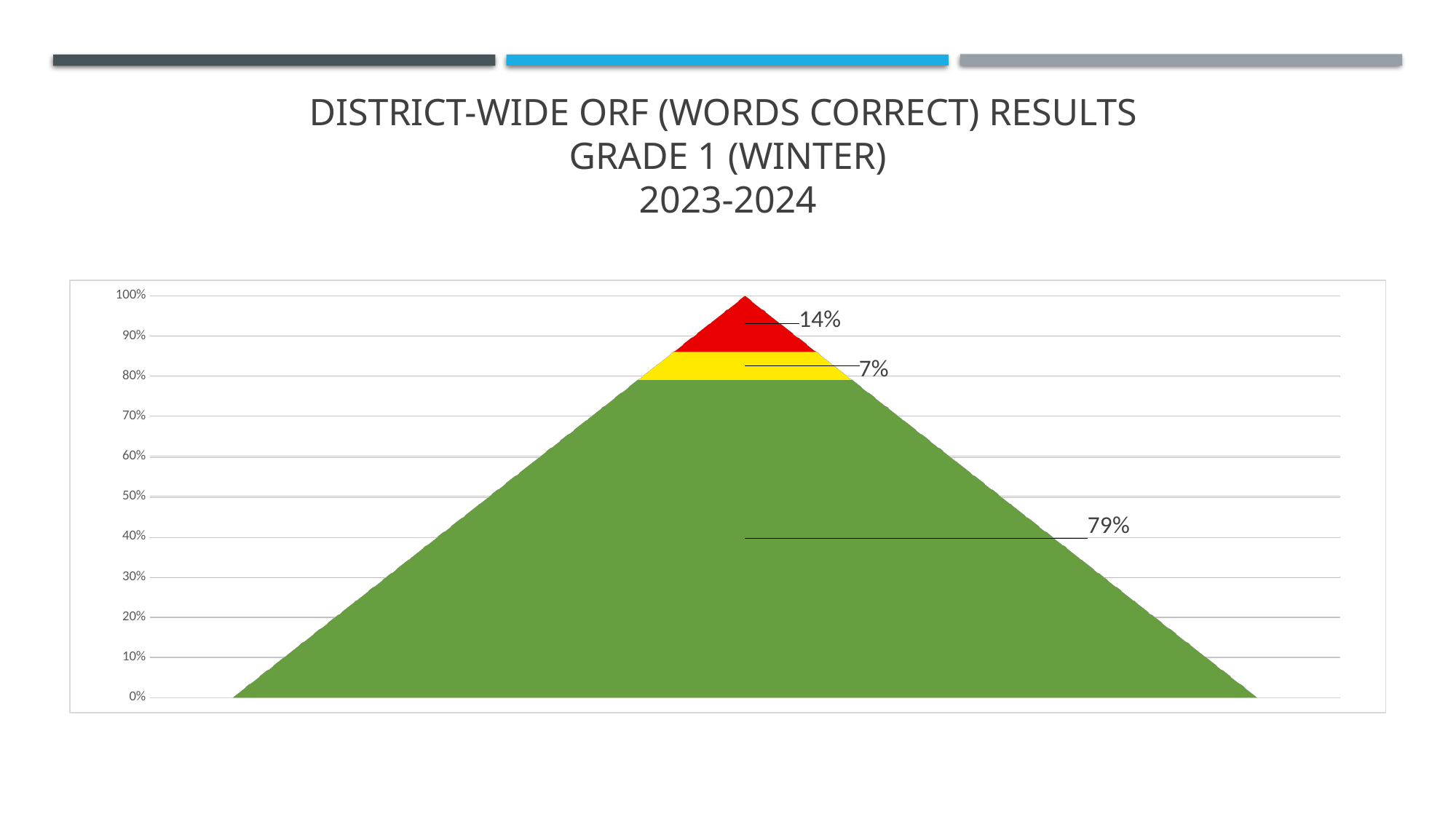
What is the difference between the green segment's percentage and the red segment's percentage? 65% What is the highest value shown on the vertical axis? 100% What percentage is shown for the yellow segment of the pyramid? 7% What percentage is shown for the green segment of the pyramid? 79% Which is larger, the red segment or the yellow segment? Red What percentage is shown for the red segment at the top of the pyramid? 14% Which coloured segment of the pyramid has the largest percentage? Green How many coloured segments make up the pyramid? 3 What do the three segment percentages add up to? 100% What is the difference between the red segment's percentage and the yellow segment's percentage? 7% Which coloured segment of the pyramid has the smallest percentage? Yellow Which grade and season does the chart title say the results are for? Grade 1 (Winter)